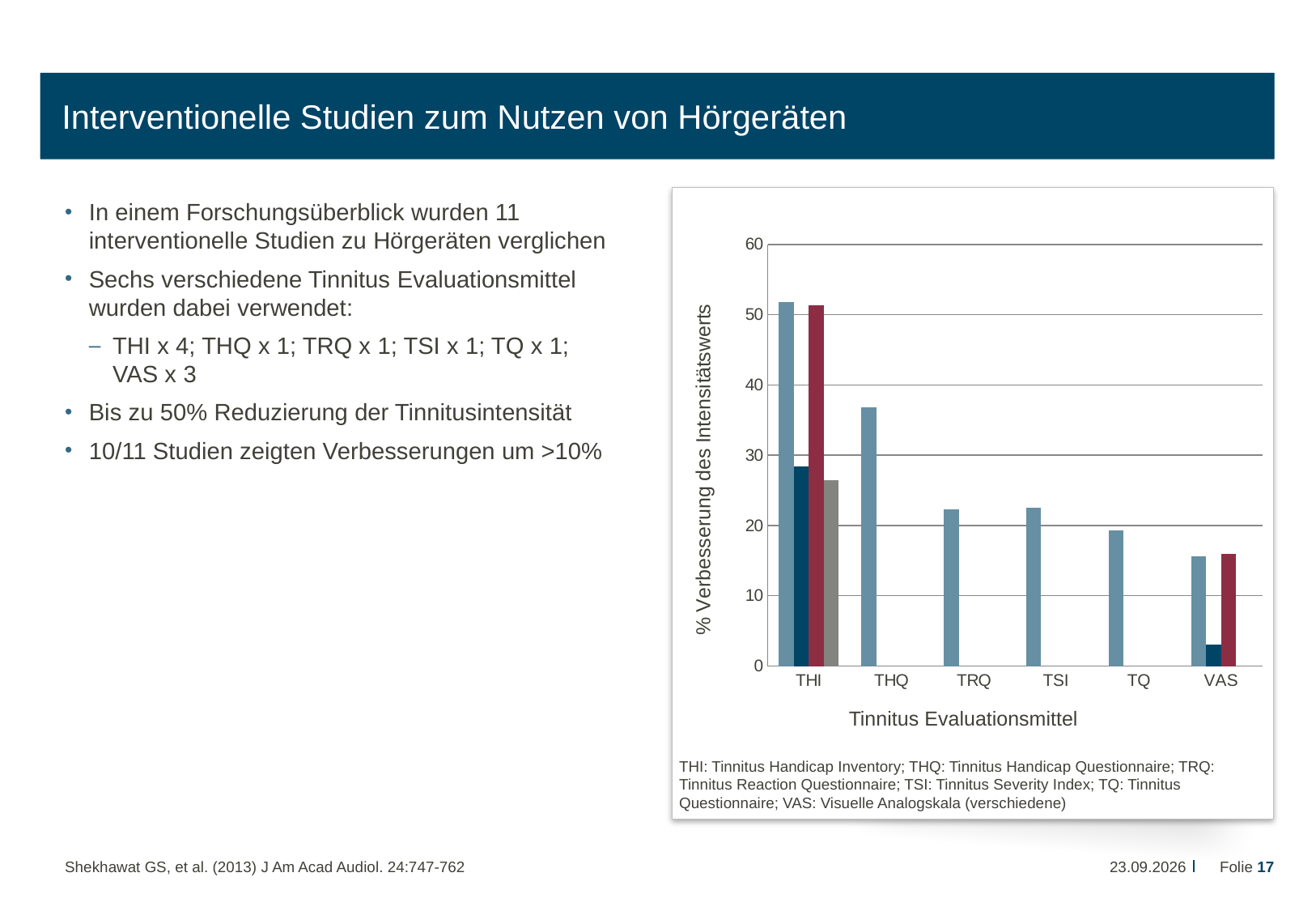
Is the value of the single bar for TRQ greater or less than 30? less Is the value of the single bar for THQ greater or less than 30? greater Is the value of the single bar for TQ greater or less than 20? less What kind of chart is shown on the slide? bar chart Which category contains the shortest bar in the chart? VAS Which category contains the tallest bar in the chart? THI How many categories are shown on the x axis of the chart? 6 Which has the larger single bar, THQ or TQ? THQ How many bars are plotted for the THI category? 4 What is the y-axis title of the chart? % Verbesserung des Intensitätswerts What is the x-axis title of the chart? Tinnitus Evaluationsmittel